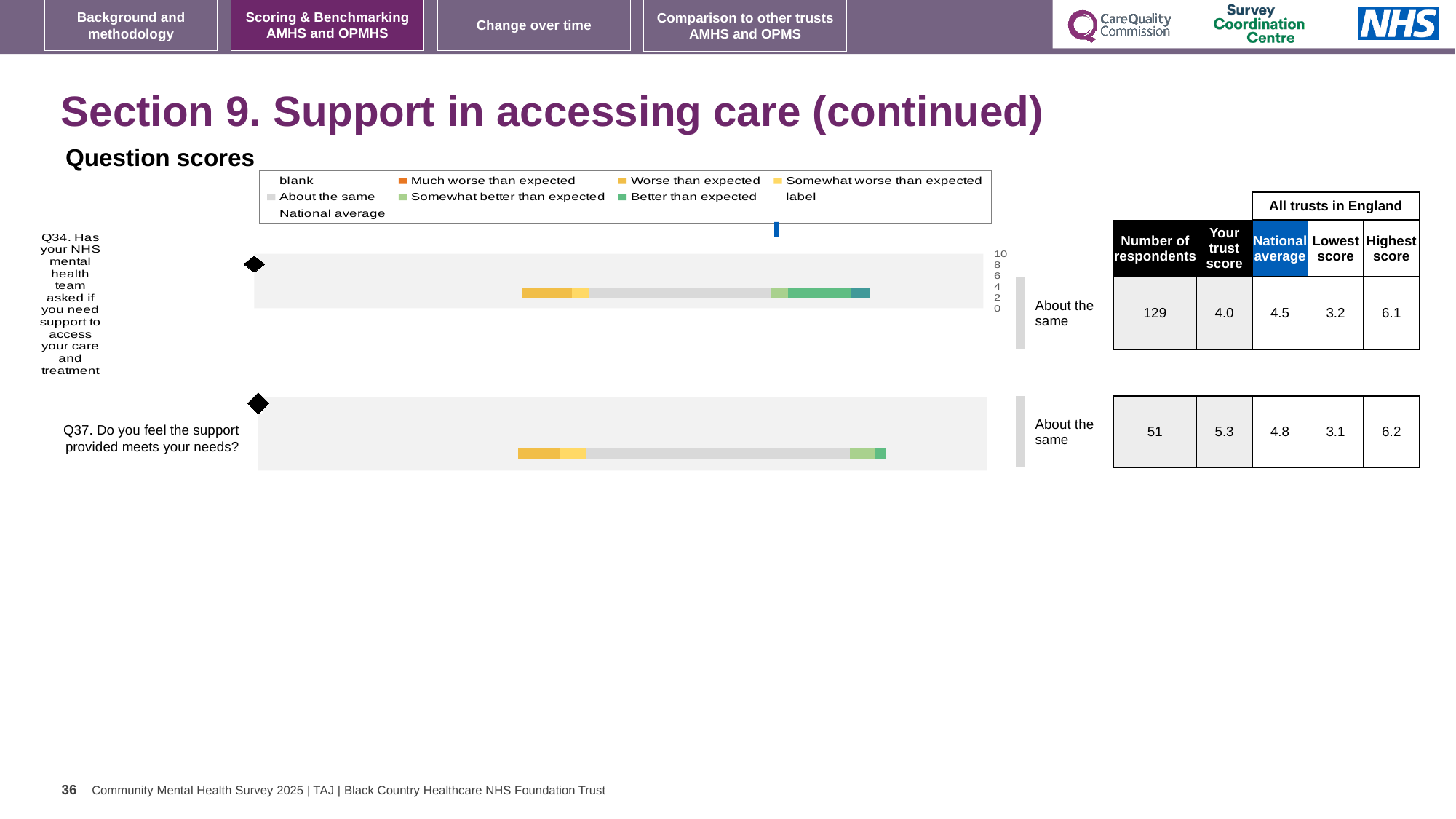
What benchmark category label is shown to the right of the bar for Q34? About the same What is the difference between the highest score and the lowest score for Q34? 2.9 What benchmark category label is shown to the right of the bar for Q37? About the same What is the lowest score among all trusts in England for Q37? 3.1 What is the trust score for Q37 (Do you feel the support provided meets your needs?)? 5.3 What kind of chart is used to show the question scores on this slide? bar chart For Q34, which is larger: the trust score or the national average? national average Which question has the higher trust score, Q34 or Q37? Q37 How many questions are plotted in the question scores chart? 2 What is the number of respondents for Q34 in the table beside the chart? 129 For Q37, which is larger: the trust score or the national average? trust score What is the national average score for Q34? 4.5